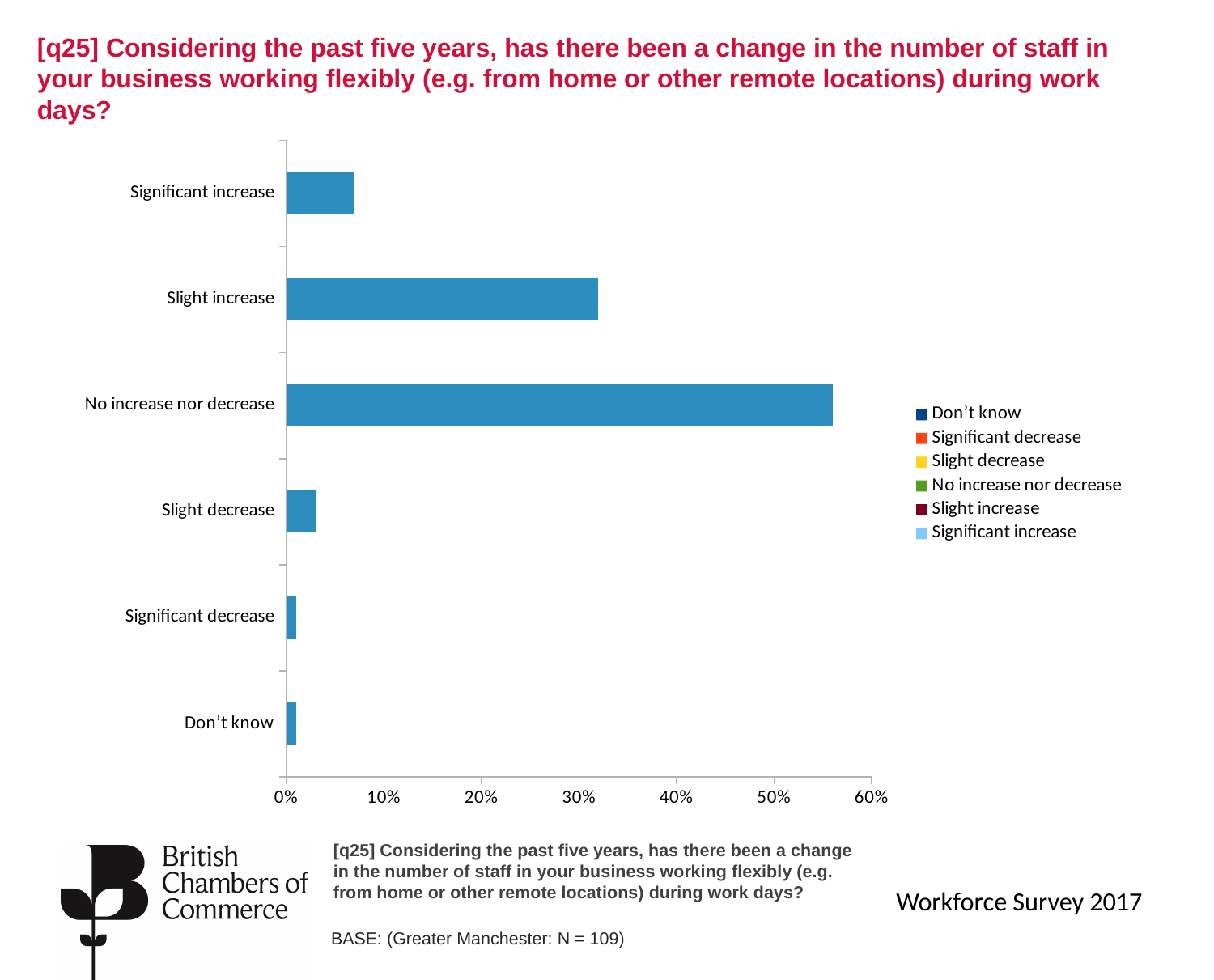
Which is larger, the value for Slight decrease or the value for Slight increase? Slight increase Is the value for No increase nor decrease greater or less than 50%? greater Is the value for Significant increase greater or less than 10%? less Is the value for Slight decrease greater or less than 10%? less What is the highest value shown on the horizontal axis? 60% How many categories are shown on the chart's vertical axis? 6 How many entries does the legend list? 6 Which category has the highest value in the chart? No increase nor decrease Which is larger, the value for Slight increase or the value for Significant increase? Slight increase What kind of chart is shown on the slide? Bar chart